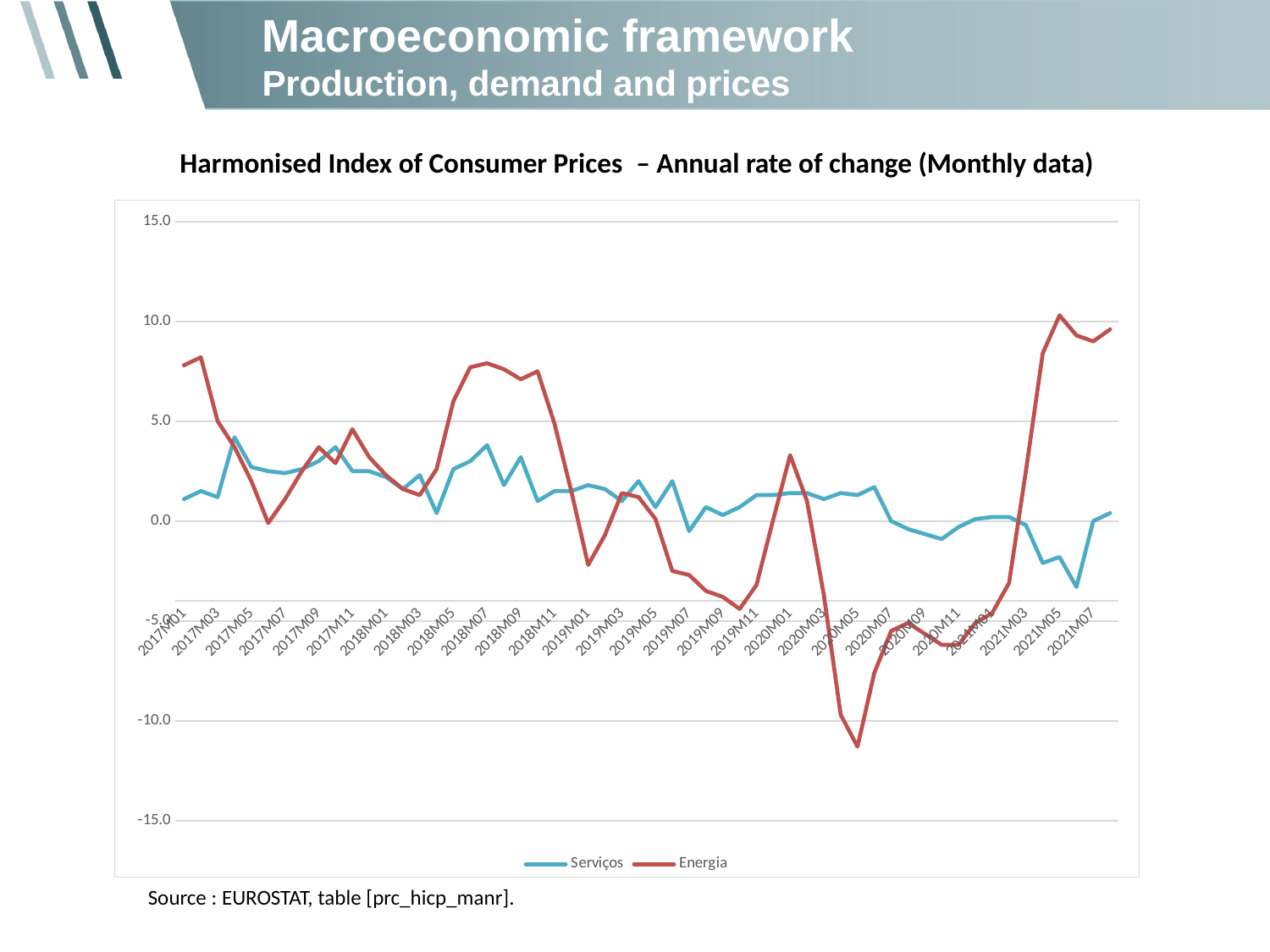
Is the value for Serviços at 2018M07 greater or less than 5.0? less Which series reaches the lowest value anywhere on the chart? Energia What colour is the Energia line? red What kind of chart is shown on the slide? line chart How many series does the legend list? 2 Is the value for Energia at 2017M01 greater or less than 5.0? greater At 2020M05, which series has the higher value, Serviços or Energia? Serviços Is the value for Energia at 2020M05 greater or less than -10.0? less What are the two series named in the legend? Serviços and Energia At 2021M07, which series has the higher value, Serviços or Energia? Energia